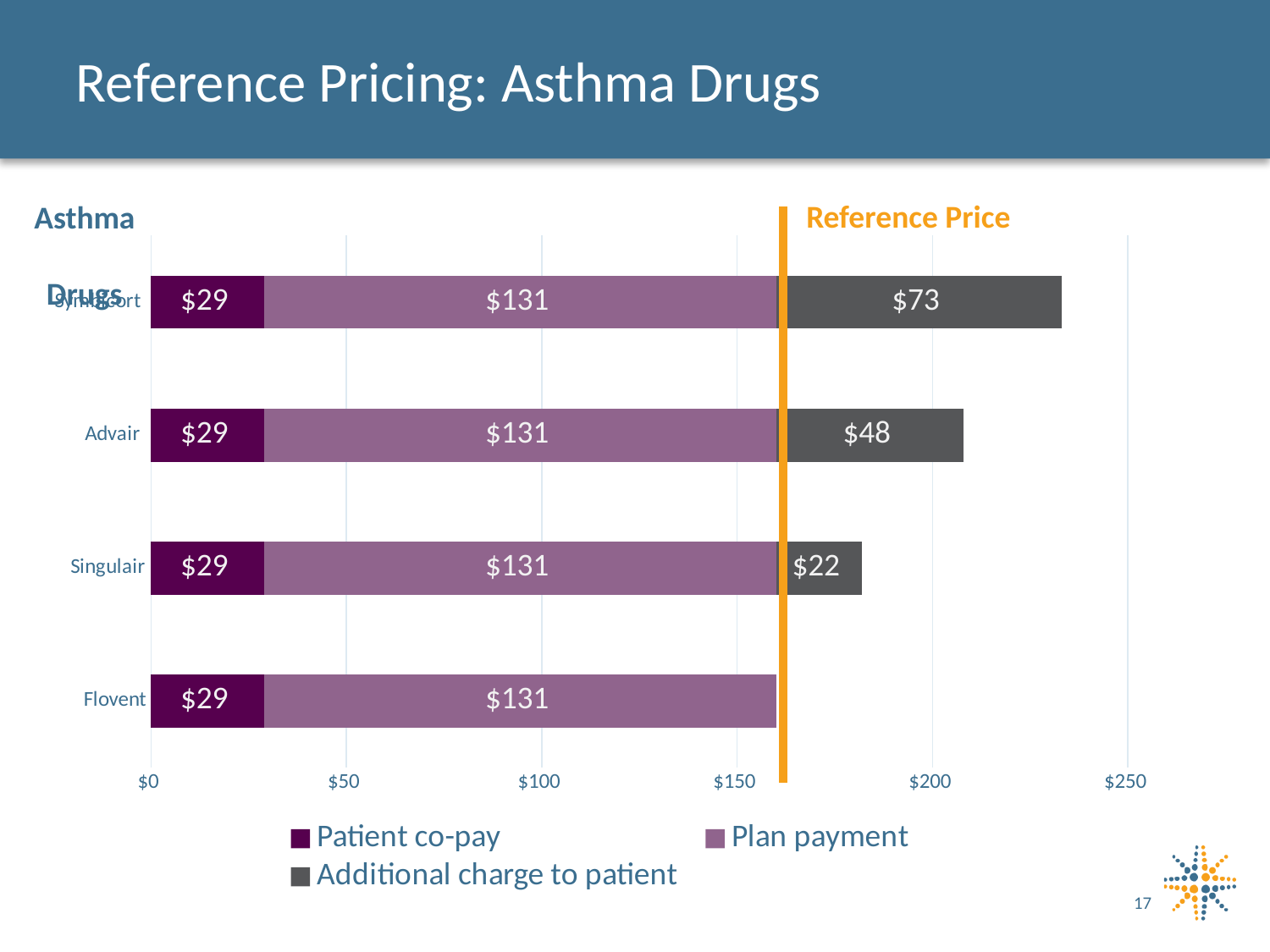
Which drug has the lowest total bar? Flovent What is the Patient co-pay for Flovent? $29 How many drugs are plotted on the chart? 4 What is the total of the stacked bar for Advair? $208 What does the orange vertical line on the chart represent? Reference Price What is the Plan payment for Singulair? $131 Is the total bar for Singulair greater or less than $200? less What kind of chart is shown on the slide? stacked bar chart What is the difference between the Additional charge to patient for Symbicort and for Singulair? $51 What is the Additional charge to patient for Advair? $48 How many series does the legend list? 3 Which drug has the highest Additional charge to patient? Symbicort